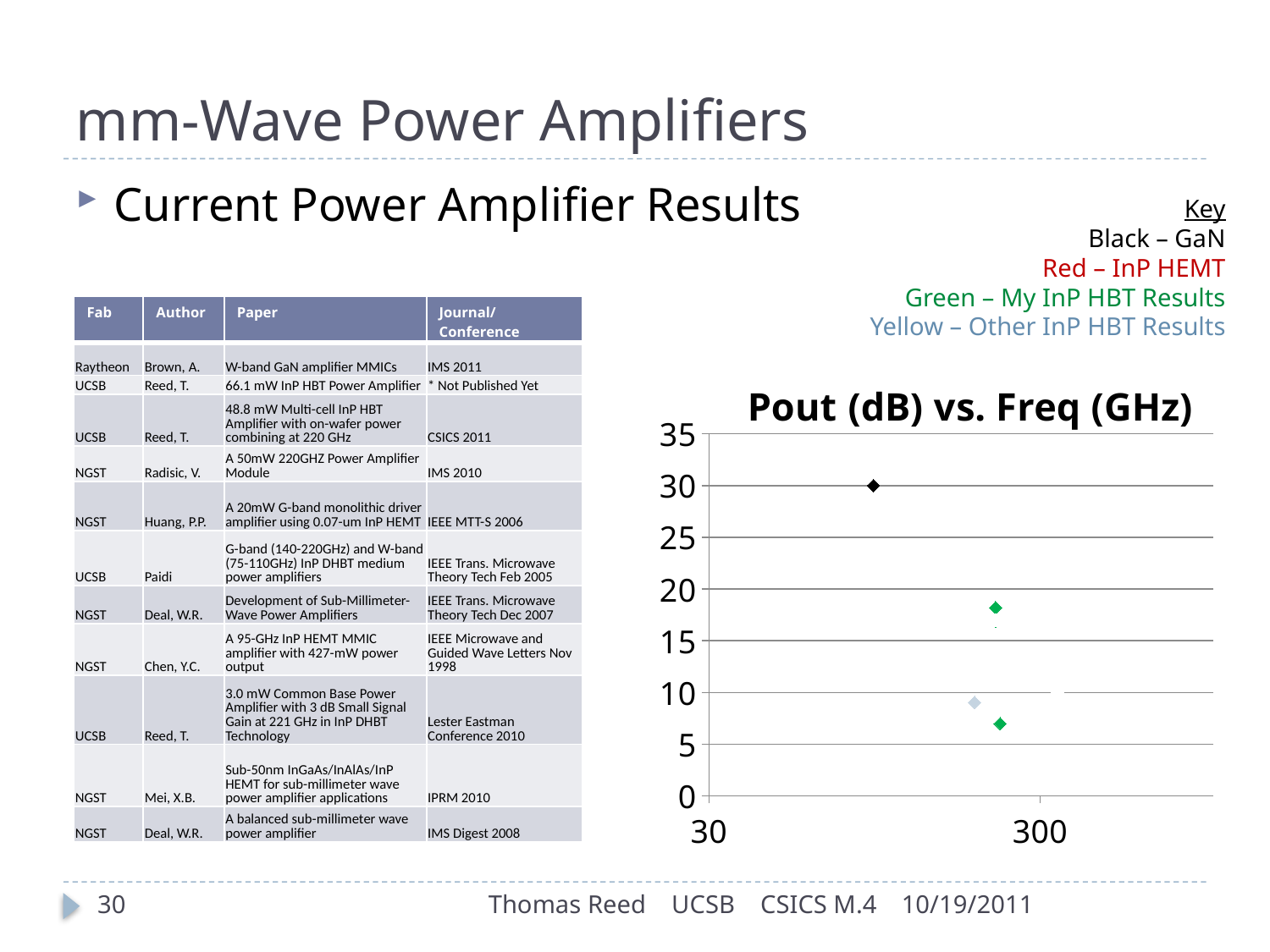
What kind of chart is shown on the slide? scatter chart Is the Pout value of the lowest green point greater or less than 10? less What is the highest value shown on the y axis? 35 Which has a higher Pout value, the black point or the upper green point? the black point What is the Pout value of the black (GaN) data point? 30 Is the Pout value of the upper green point greater or less than 15? greater According to the key, which colour represents GaN results? Black What is the title of the chart? Pout (dB) vs. Freq (GHz) Is the Pout value of the upper green point greater or less than 20? less Which data point has the highest Pout value? the black (GaN) point